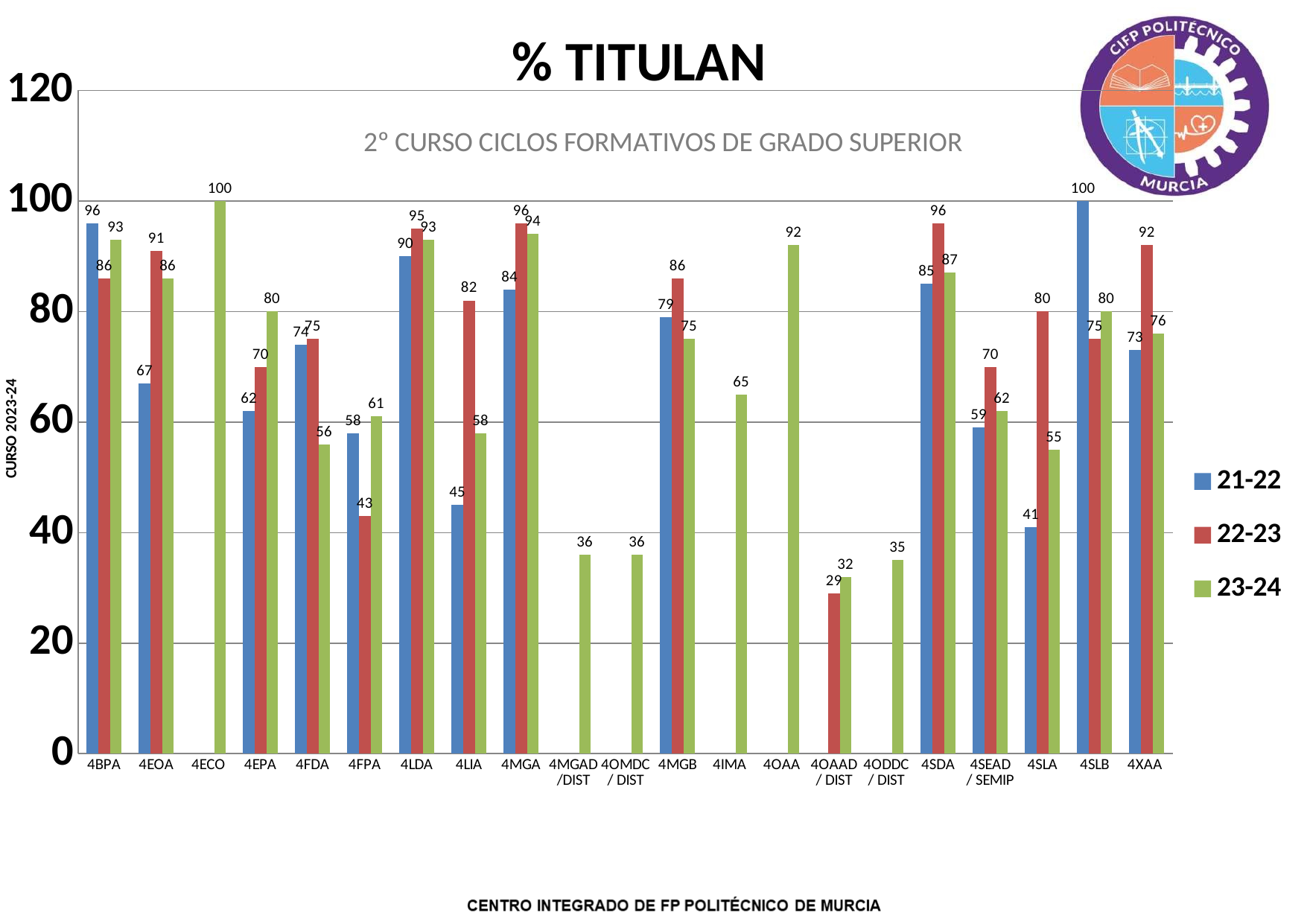
How many series does the legend list? 3 What is the difference between the 22-23 and 21-22 values for 4SLA? 39 Which category has the lowest 22-23 value? 4OAAD / DIST What kind of chart is shown on the slide? bar chart How many categories are shown on the x axis? 21 Which category has the highest 21-22 value? 4SLB What is the 23-24 value for 4ECO? 100 What is the 21-22 value for 4SLA? 41 Which is larger for 4FPA, the 21-22 value or the 22-23 value? 21-22 What is the 22-23 value for 4LIA? 82 Is the 23-24 value for 4IMA greater or less than 60? greater What is the title of the chart? % TITULAN